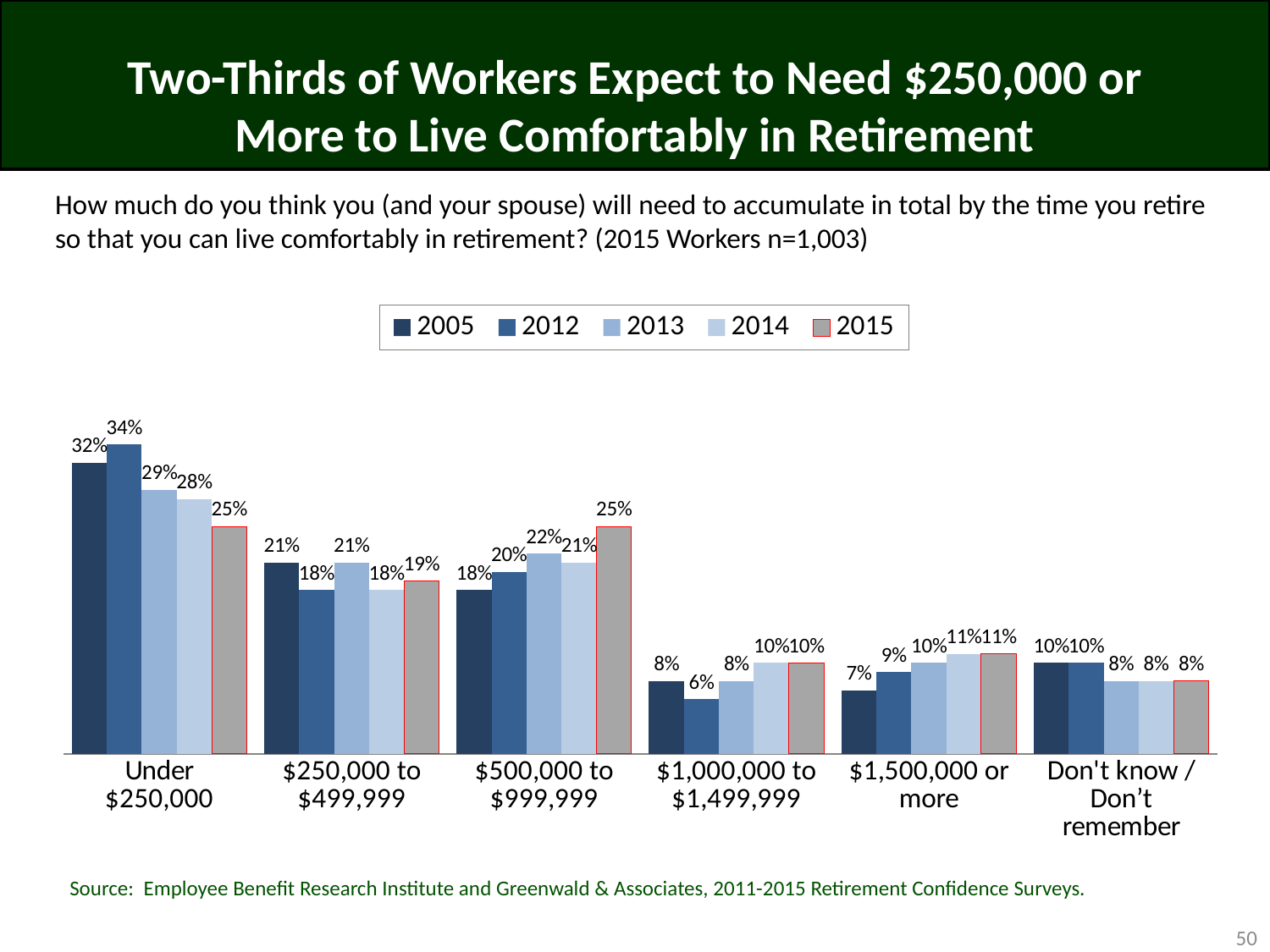
What is the 2005 value for the $1,500,000 or more category? 7% What is the 2013 value for the Don't know / Don't remember category? 8% How many response categories are shown on the x axis? 6 What kind of chart is shown on the slide? Bar chart Which year has the highest value in the Under $250,000 category? 2012 What percentage of workers in 2015 expected to need under $250,000? 25% How many series does the legend list? 5 What is the difference between the 2005 and 2015 values for the Under $250,000 category? 7% What is the 2012 value for the $500,000 to $999,999 category? 20% What is the difference between the 2015 and 2005 values for the $500,000 to $999,999 category? 7% Which year has the lowest value in the $1,000,000 to $1,499,999 category? 2012 In 2015, which is larger: the value for Under $250,000 or the value for $250,000 to $499,999? Under $250,000